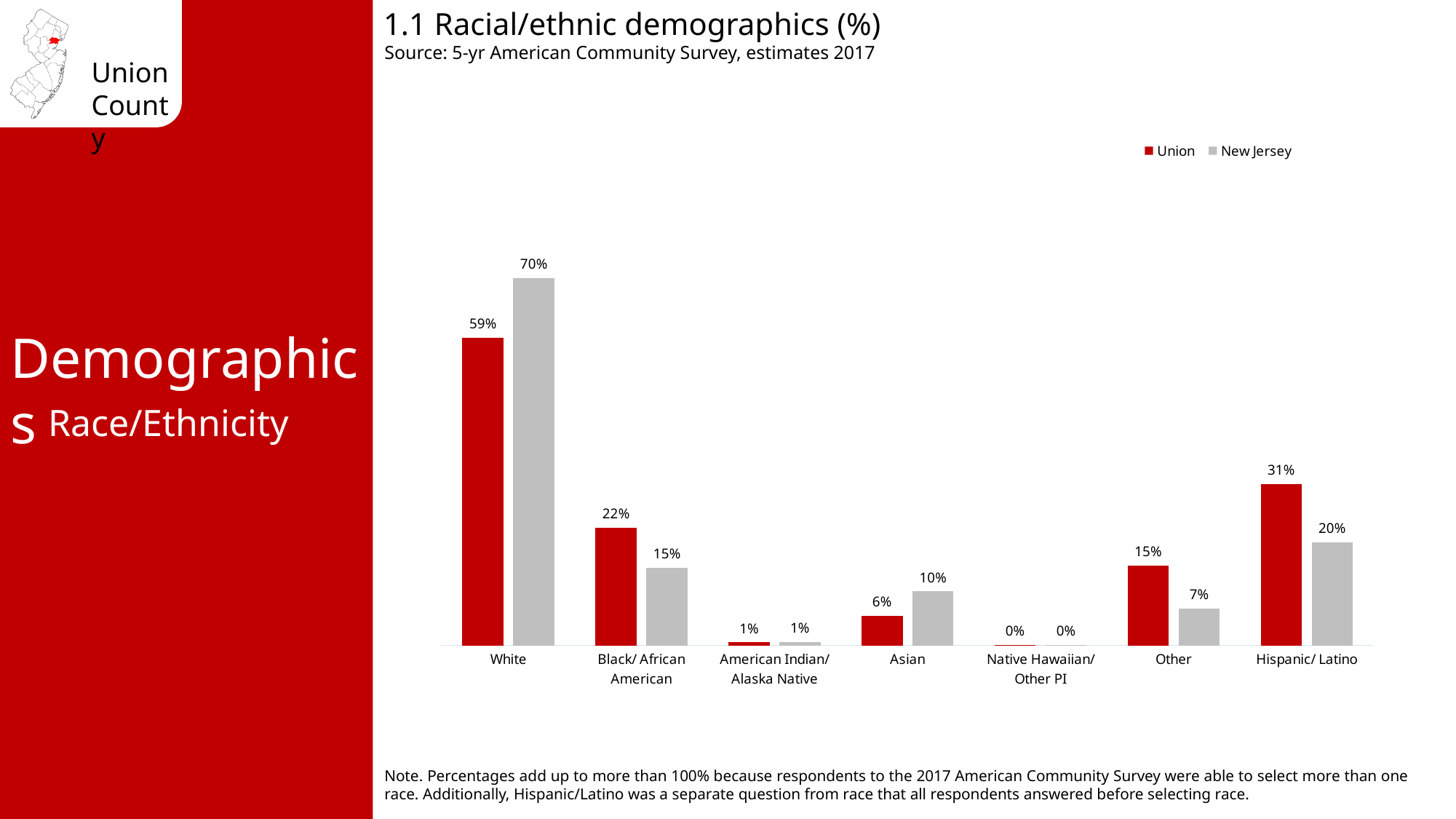
Which is larger for Other, the Union value or the New Jersey value? Union Which category has the highest New Jersey value? White What is the New Jersey value for Hispanic/ Latino? 20% What is the difference between the New Jersey and Union values for White? 11% How many series does the legend list? 2 What is the difference between the Union and New Jersey values for Hispanic/ Latino? 11% What kind of chart is shown? Bar chart What is the Union value for White? 59% Which is larger for Asian, the Union value or the New Jersey value? New Jersey How many categories are shown on the x axis? 7 Which category has the highest Union value? White What is the Union value for Black/ African American? 22%